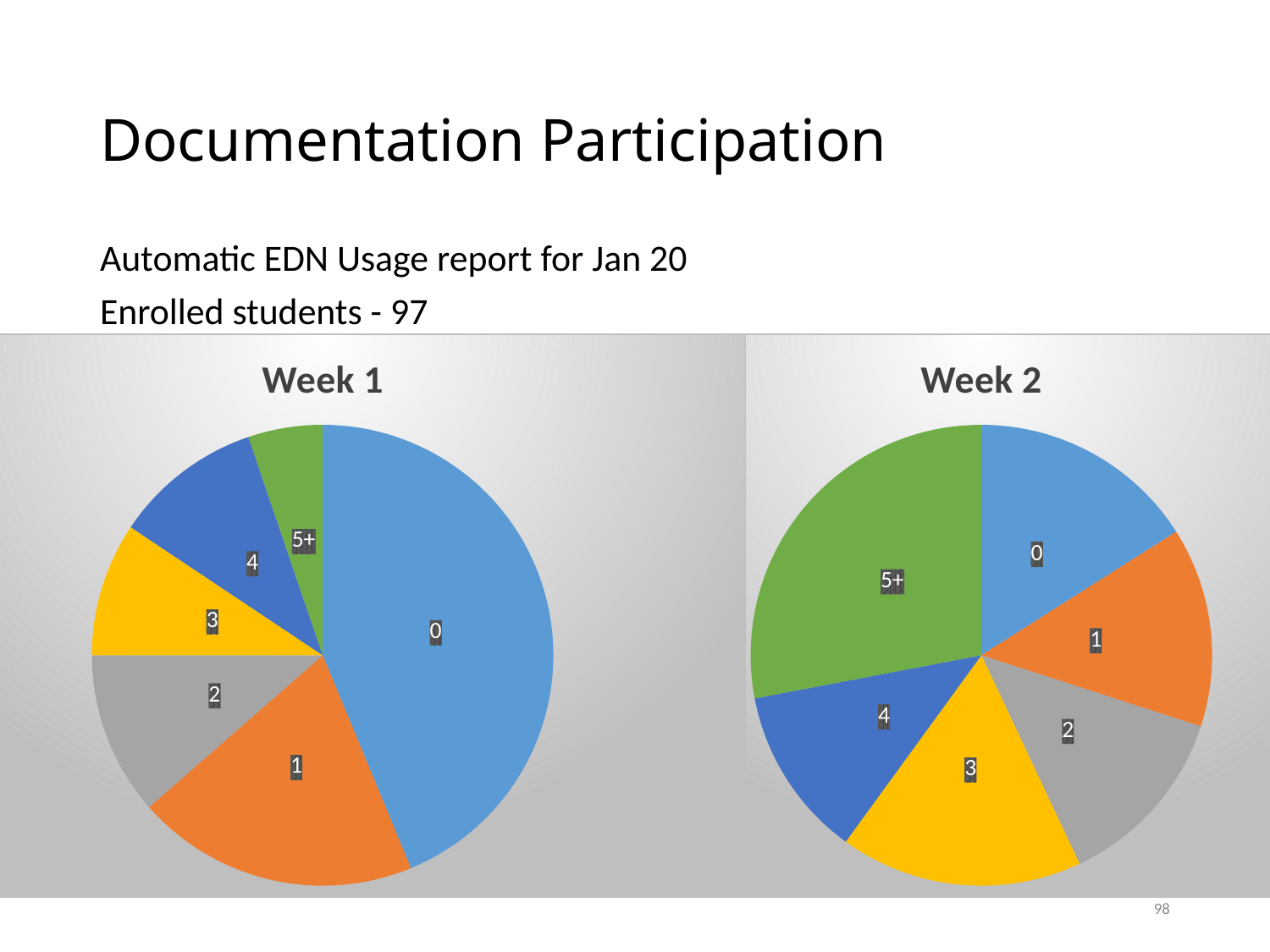
In the Week 2 chart, which category has the largest slice? 5+ What kind of chart is the Week 1 chart? pie chart In the Week 1 chart, which category has the smallest slice? 5+ What is the title of the pie chart on the right side of the slide? Week 2 In the Week 1 chart, which slice is larger, 0 or 1? 0 In the Week 1 chart, how many slices does the pie have? 6 In the Week 1 chart, which slice is larger, 1 or 5+? 1 What kind of chart is the Week 2 chart? pie chart In the Week 2 chart, which slice is larger, 5+ or 0? 5+ In the Week 2 chart, what colour is the 5+ slice? green In the Week 2 chart, how many slices does the pie have? 6 In the Week 1 chart, which category has the largest slice? 0